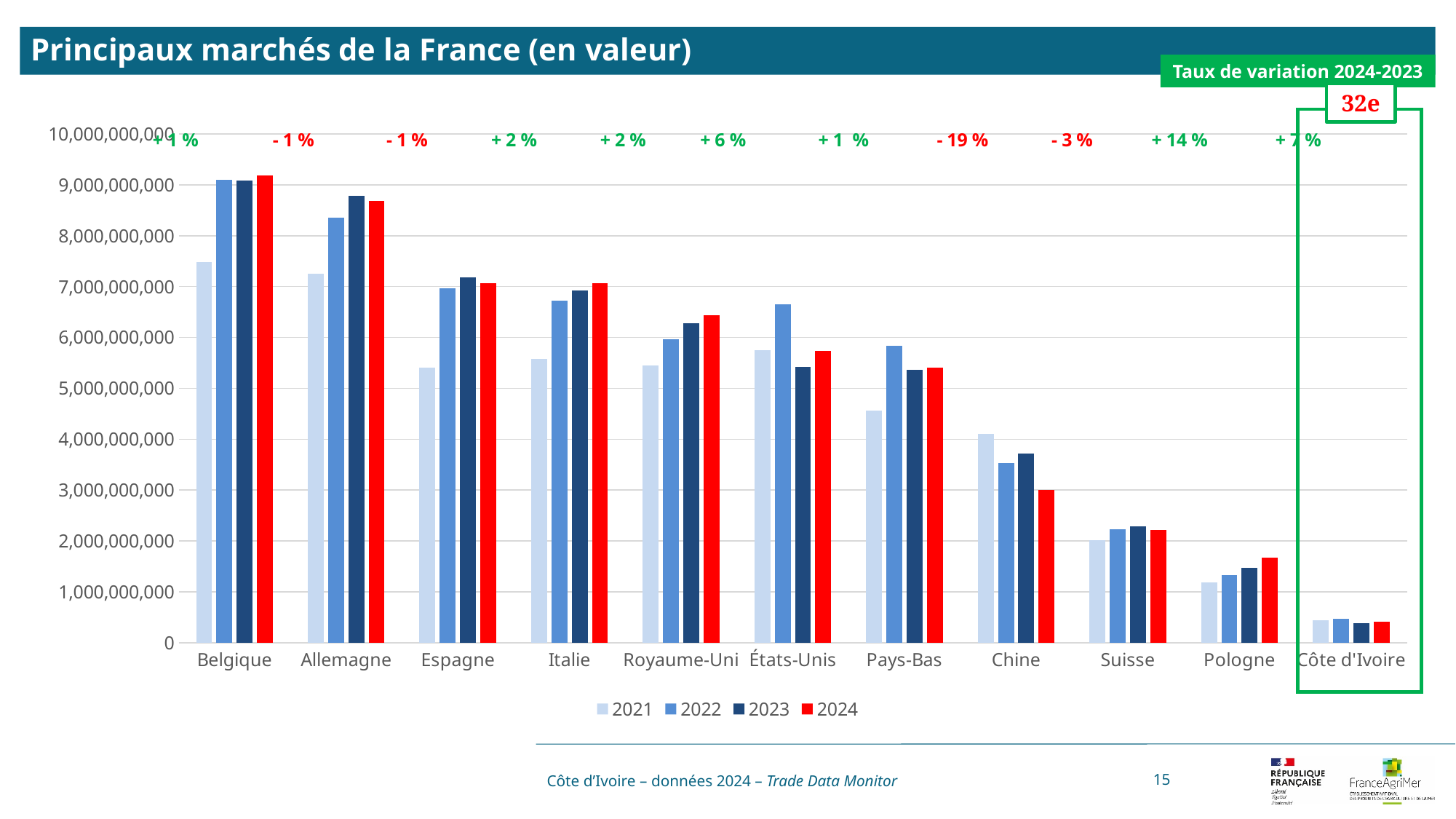
How many countries are shown on the x axis of the chart? 11 What is the 2024-2023 variation rate shown for Pologne? + 14 % Which country has the lowest 2024 value? Côte d'Ivoire How many series does the legend list? 4 What kind of chart is shown on the slide? bar chart Do the values for Pologne rise or fall from 2021 to 2024? rise What is the 2024-2023 variation rate shown for Chine? - 19 % Which is larger: the 2022 value for États-Unis or the 2022 value for Pays-Bas? États-Unis What is the title of the chart? Principaux marchés de la France (en valeur) Is the 2024 value for Suisse greater or less than 3,000,000,000? less Which country has the highest 2024 value? Belgique Is the 2022 value for Allemagne greater or less than 8,000,000,000? greater